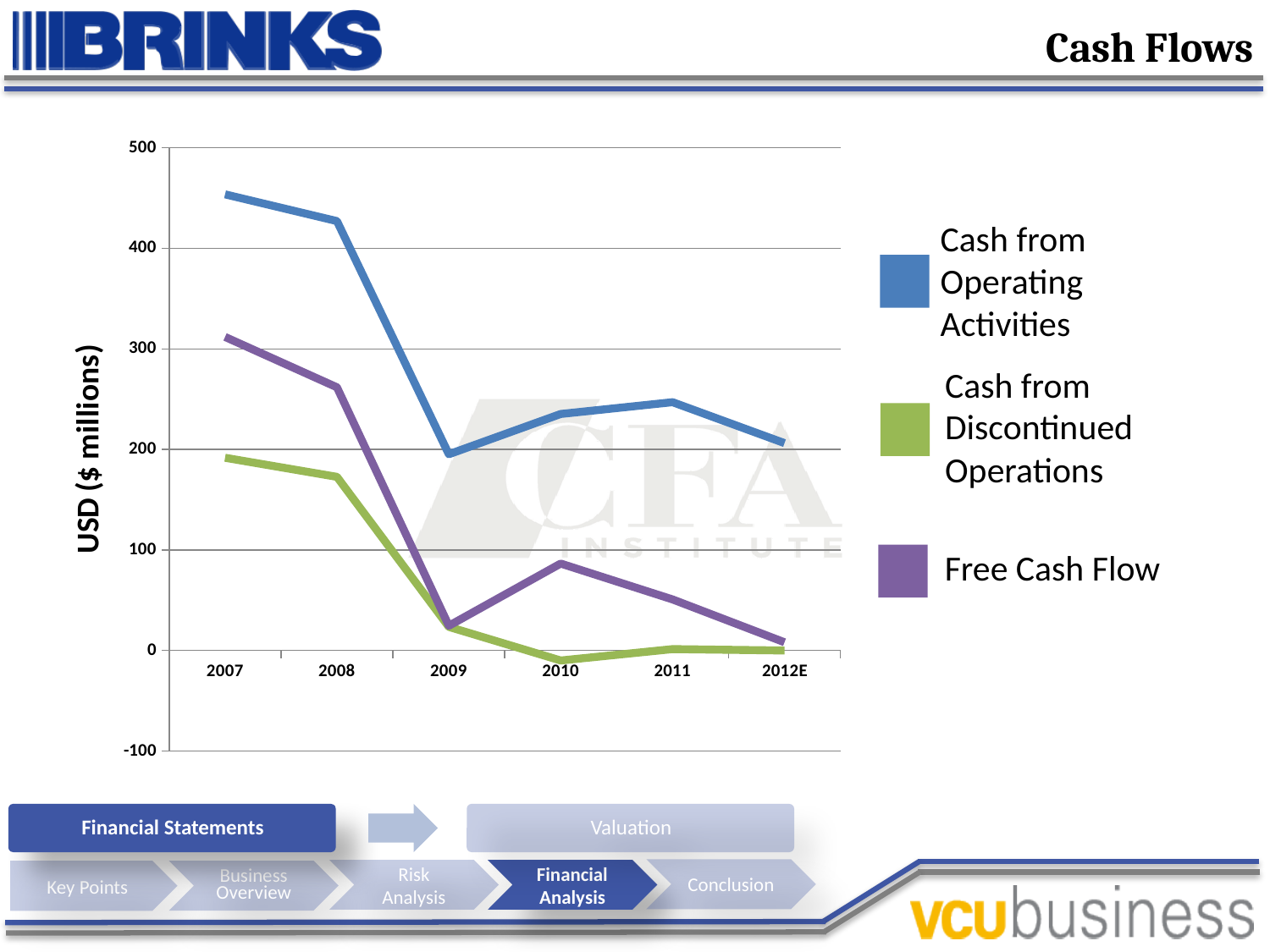
How many series does the legend list? 3 Which series is drawn in purple? Free Cash Flow Is the value for Free Cash Flow in 2010 greater or less than 100? less Does Cash from Operating Activities rise or fall from 2007 to 2009? fall Is the value for Cash from Operating Activities in 2007 greater or less than 400? greater What is the label of the y axis? USD ($ millions) Is the value for Cash from Discontinued Operations in 2010 greater or less than 0? less In which year is Free Cash Flow highest? 2007 In 2007, which is larger: Cash from Operating Activities or Free Cash Flow? Cash from Operating Activities What kind of chart is shown on the slide? line chart How many years are shown on the x axis? 6 In which year is Cash from Operating Activities highest? 2007